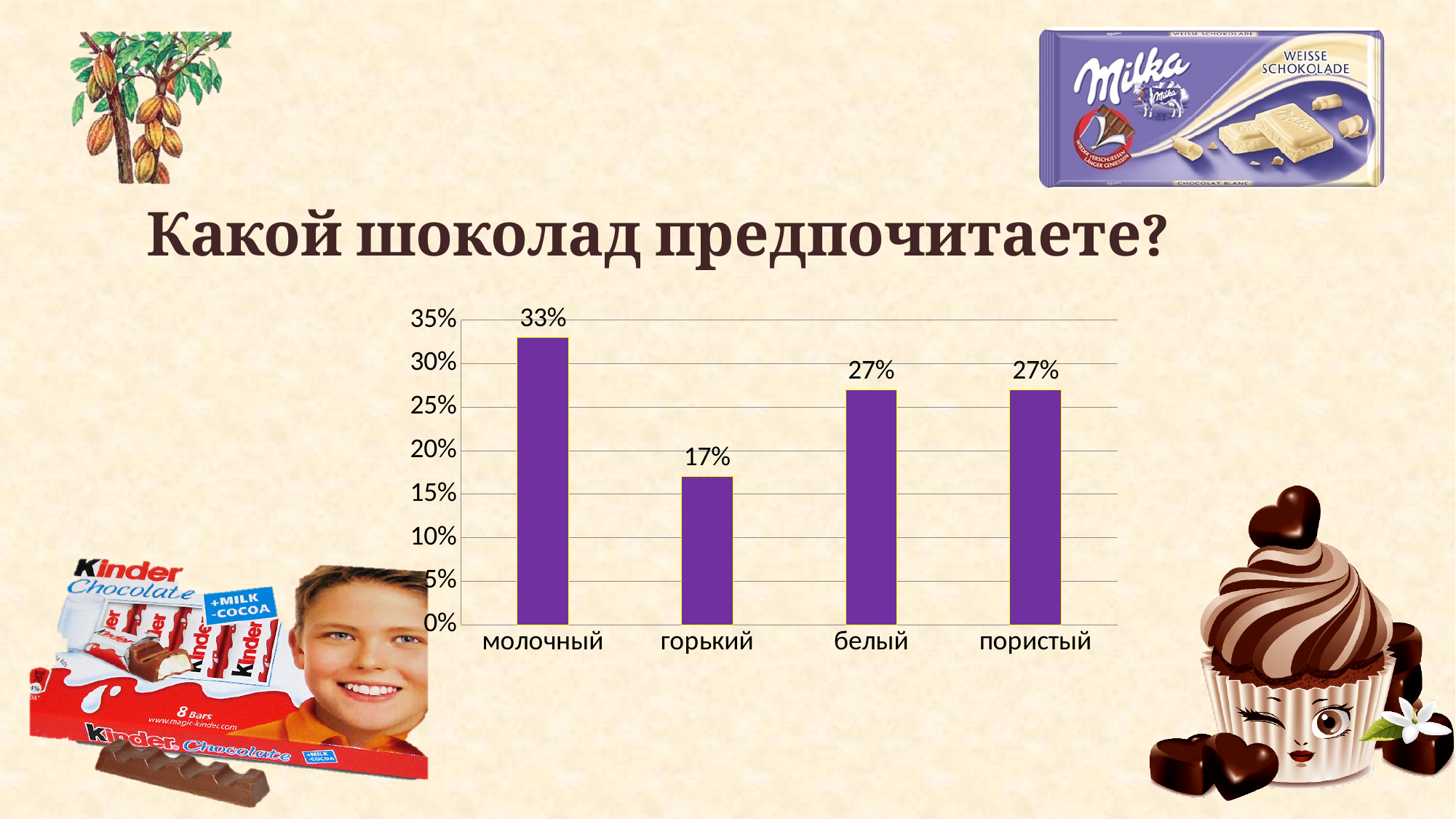
What is the difference between the values for молочный and горький? 16% How many categories are shown on the x axis? 4 What is the value for пористый? 27% What is the difference between the values for белый and горький? 10% What kind of chart is shown on the slide? bar chart Which category has the lowest value? горький Which is larger, the value for молочный or the value for белый? молочный What is the value for горький? 17% Which category has the highest value? молочный What is the value for молочный? 33% What is the title of the slide above the chart? Какой шоколад предпочитаете? What is the value for белый? 27%